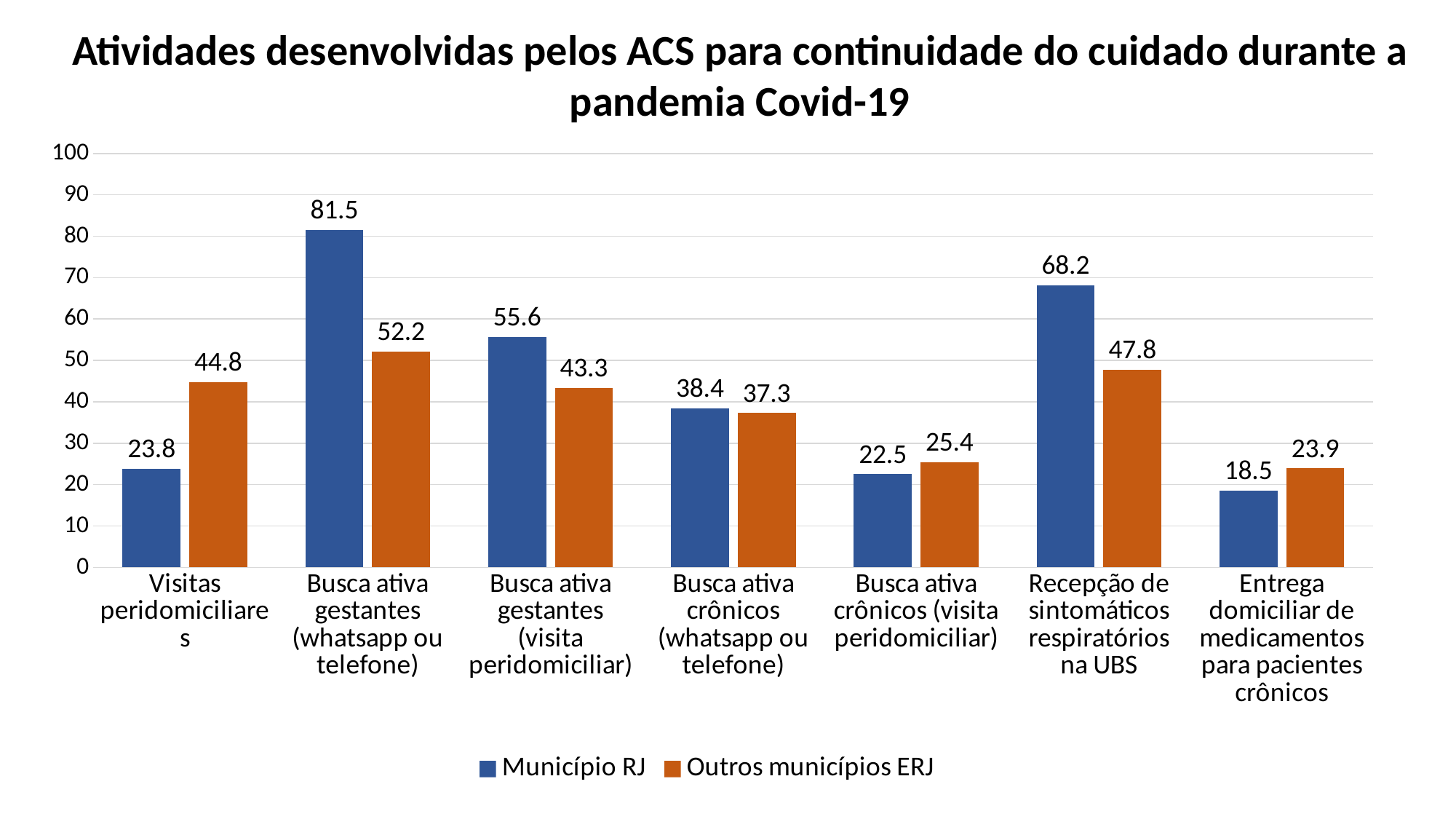
What is the value for Outros municípios ERJ for 'Visitas peridomiciliares'? 44.8 Which category has the lowest value for Município RJ? Entrega domiciliar de medicamentos para pacientes crônicos Which category has the lowest value for Outros municípios ERJ? Entrega domiciliar de medicamentos para pacientes crônicos What is the value for Município RJ for 'Busca ativa gestantes (whatsapp ou telefone)'? 81.5 For 'Busca ativa crônicos (visita peridomiciliar)', which series has the larger value? Outros municípios ERJ What is the difference between Outros municípios ERJ and Município RJ for 'Visitas peridomiciliares'? 21 How many categories are shown on the x axis? 7 What is the value for Outros municípios ERJ for 'Recepção de sintomáticos respiratórios na UBS'? 47.8 Which category has the highest value for Município RJ? Busca ativa gestantes (whatsapp ou telefone) What kind of chart is shown on the slide? Bar chart What is the difference between Município RJ and Outros municípios ERJ for 'Busca ativa gestantes (whatsapp ou telefone)'? 29.3 How many series does the legend list? 2